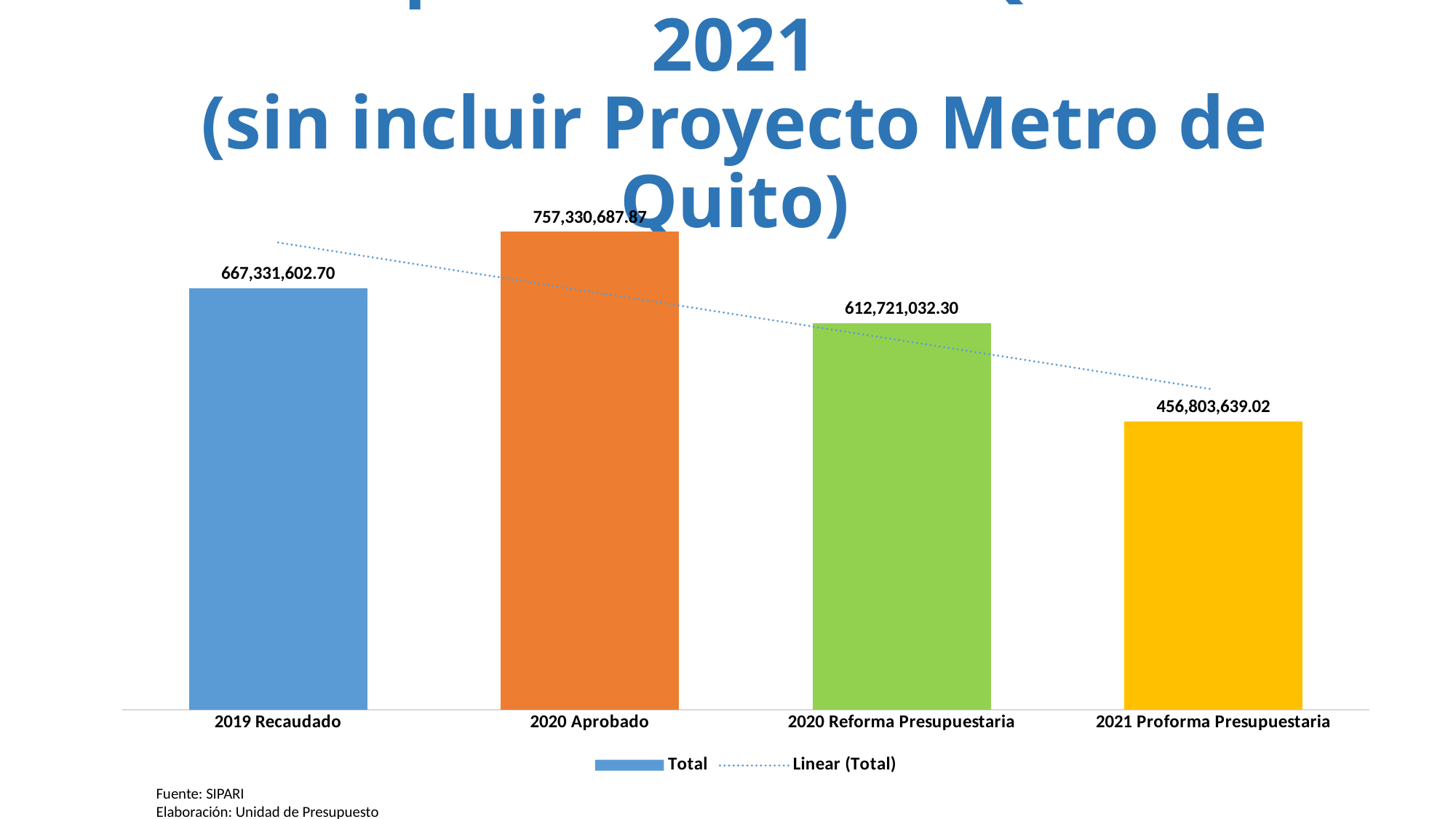
What kind of chart is shown on the slide? Bar chart Which is larger, the value for 2019 Recaudado or the value for 2020 Reforma Presupuestaria? 2019 Recaudado How many entries does the legend list? 2 Which category has the lowest value? 2021 Proforma Presupuestaria How many categories are shown on the x axis? 4 What is the value for 2020 Reforma Presupuestaria? 612,721,032.30 What is the difference between the values for 2020 Aprobado and 2019 Recaudado? 89,999,085.17 Which category has the highest value? 2020 Aprobado What is the value for 2020 Aprobado? 757,330,687.87 What is the difference between the values for 2020 Reforma Presupuestaria and 2021 Proforma Presupuestaria? 155,917,393.28 What is the value for 2019 Recaudado? 667,331,602.70 What is the value for 2021 Proforma Presupuestaria? 456,803,639.02